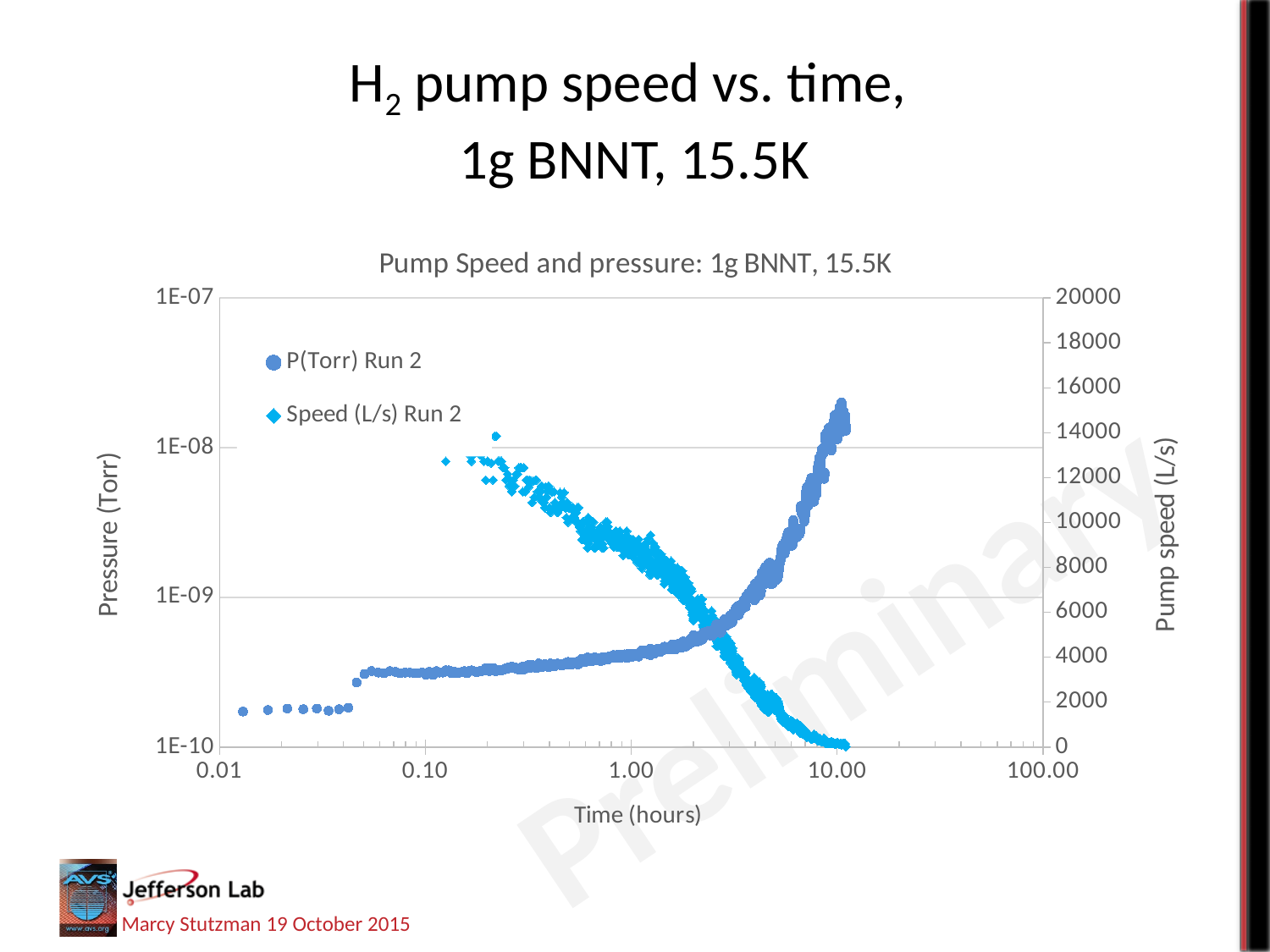
Is the Speed (L/s) Run 2 value at about 0.20 hours greater or less than 10000? greater Is the Speed (L/s) Run 2 value at about 1.00 hours greater or less than 6000? greater How many series does the chart legend list? 2 Is the P(Torr) Run 2 value at about 10.00 hours greater or less than 1E-08? greater Does the Speed (L/s) Run 2 series rise or fall as time increases along the x axis? Fall What is the title of the chart? Pump Speed and pressure: 1g BNNT, 15.5K What kind of chart is shown on the slide? Scatter chart Does the P(Torr) Run 2 series rise or fall as time increases along the x axis? Rise What are the two series named in the chart legend? P(Torr) Run 2 and Speed (L/s) Run 2